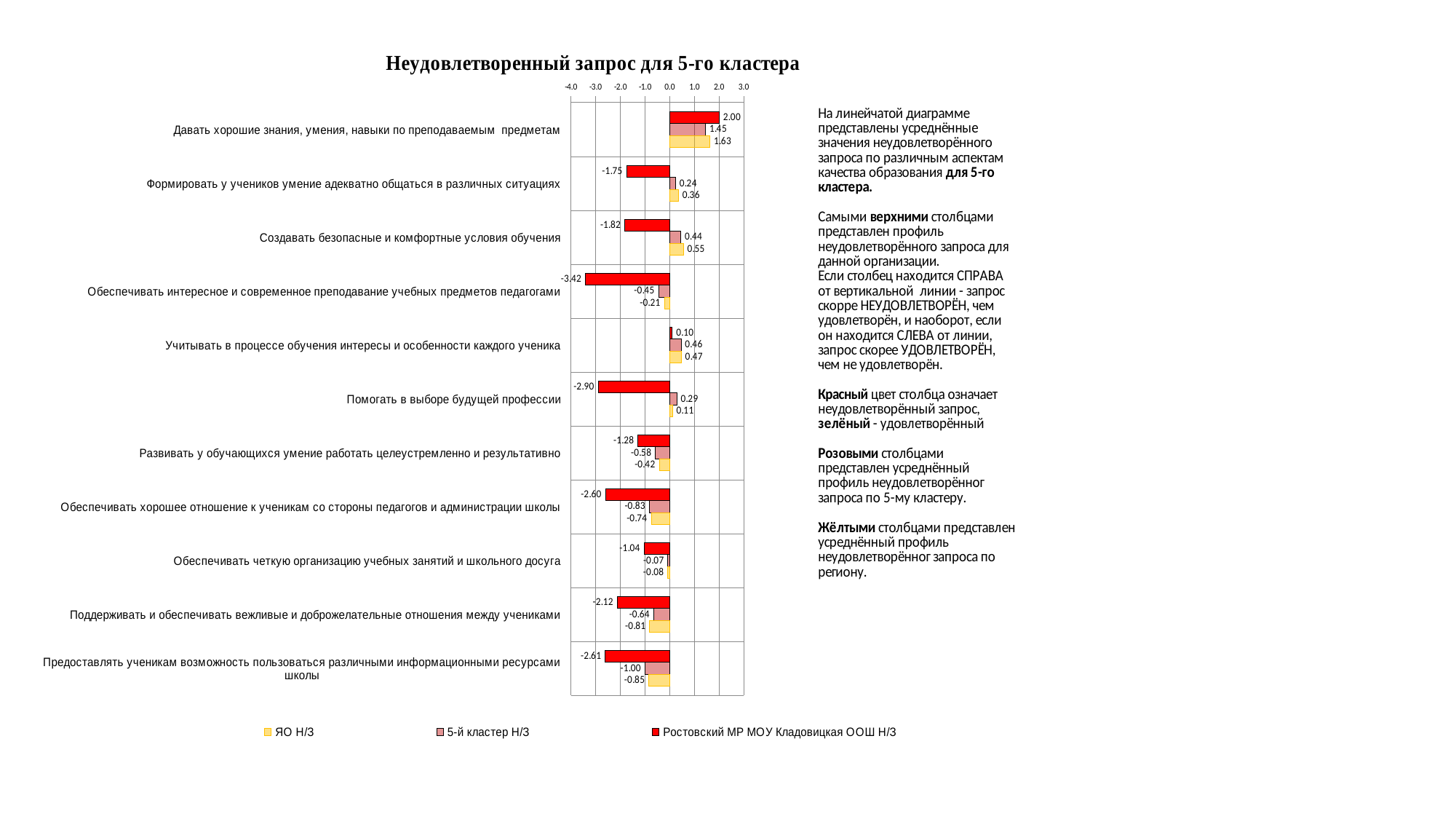
What is the value for 'ЯО Н/З' in the category 'Создавать безопасные и комфортные условия обучения'? 0.55 What is the value for 'Ростовский МР МОУ Кладовицкая ООШ Н/З' in the category 'Давать хорошие знания, умения, навыки по преподаваемым предметам'? 2.00 In which category does 'Ростовский МР МОУ Кладовицкая ООШ Н/З' have its lowest value? Обеспечивать интересное и современное преподавание учебных предметов педагогами Is the value for 'Ростовский МР МОУ Кладовицкая ООШ Н/З' in the category 'Помогать в выборе будущей профессии' greater or less than -2.0? less What is the difference between the 'ЯО Н/З' and '5-й кластер Н/З' values in the category 'Давать хорошие знания, умения, навыки по преподаваемым предметам'? 0.18 How many categories are plotted on the chart? 11 What is the value for '5-й кластер Н/З' in the category 'Помогать в выборе будущей профессии'? 0.29 How many series does the legend list? 3 What is the title of the chart? Неудовлетворенный запрос для 5-го кластера Which is larger in the category 'Предоставлять ученикам возможность пользоваться различными информационными ресурсами школы': the value for '5-й кластер Н/З' or for 'ЯО Н/З'? ЯО Н/З What type of chart is shown on the slide? bar chart In which category does 'ЯО Н/З' have its highest value? Давать хорошие знания, умения, навыки по преподаваемым предметам